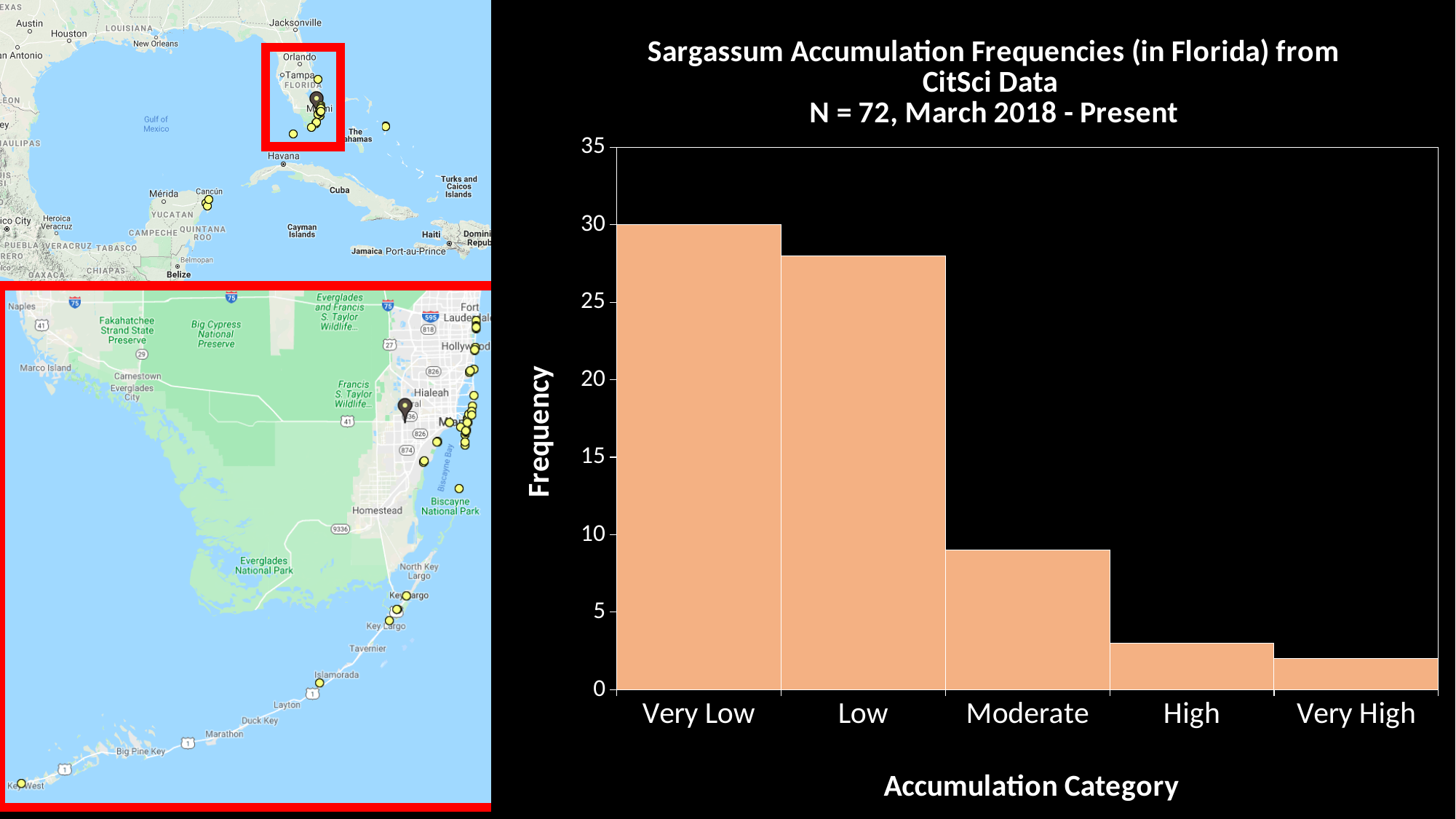
Is the frequency for the Moderate category greater or less than 10? less Which accumulation category has the highest frequency? Very Low Is the frequency for the High category greater or less than 5? less How many accumulation categories are shown on the x axis of the chart? 5 What kind of chart is shown on the slide? bar chart What is the label on the x axis of the chart? Accumulation Category Which accumulation category has the lowest frequency? Very High Do the frequencies rise or fall moving from Very Low to Very High along the x axis? fall Which has a higher frequency, Moderate or High? Moderate Is the frequency for the Low category greater or less than 25? greater What is the label on the y axis of the chart? Frequency What is the frequency for the Very Low category? 30